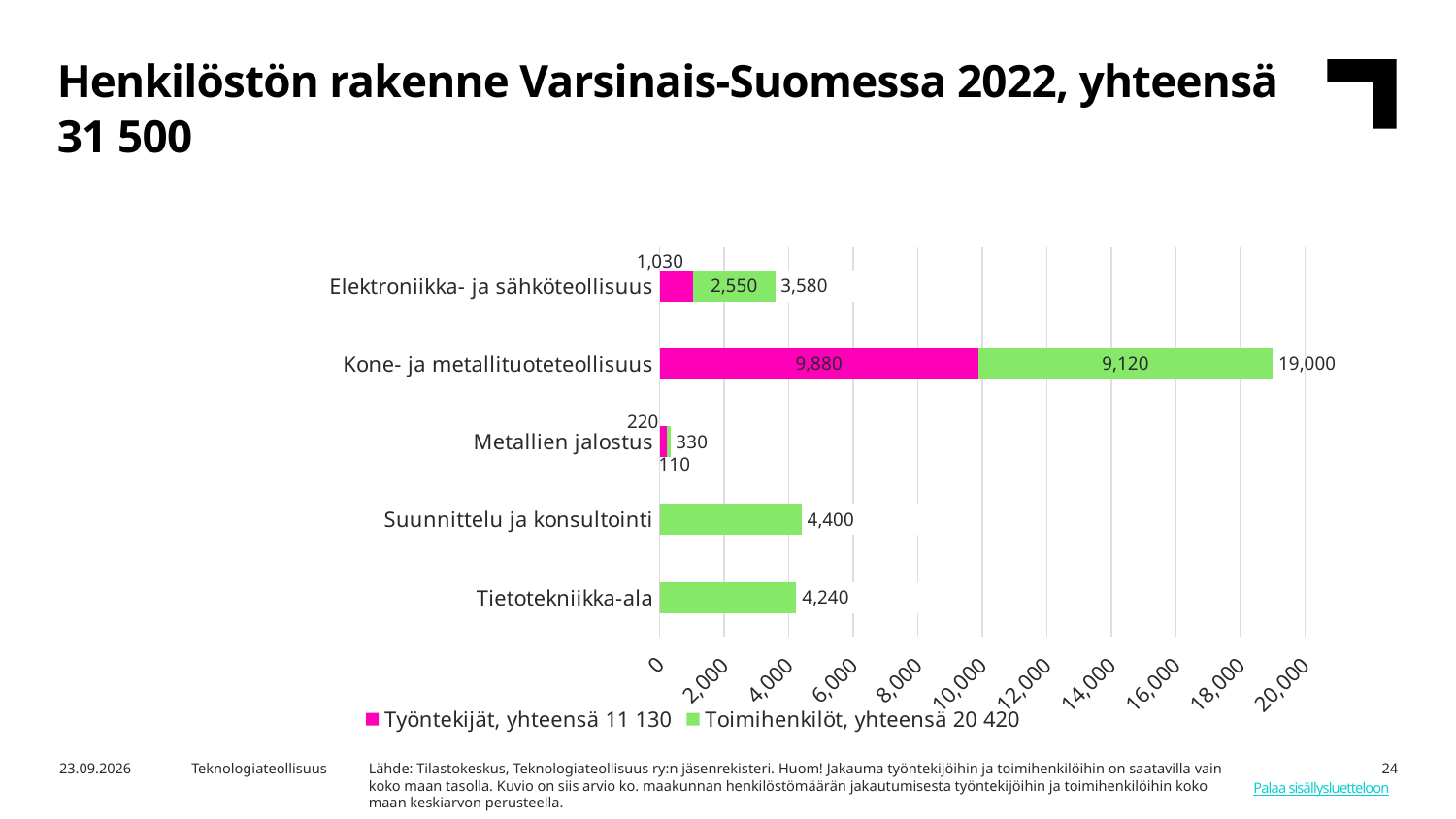
Which is larger, the Työntekijät value or the Toimihenkilöt value for Kone- ja metallituoteteollisuus? Työntekijät What is the difference between the totals for Suunnittelu ja konsultointi and Tietotekniikka-ala? 160 Which category has the highest total? Kone- ja metallituoteteollisuus How many series does the legend list? 2 What is the Toimihenkilöt value for Elektroniikka- ja sähköteollisuus? 2,550 What is the total for the Metallien jalostus bar? 330 What total is given for Toimihenkilöt in the legend? 20 420 Which category has the lowest total? Metallien jalostus How many categories are shown on the chart? 5 What kind of chart is shown on the slide? Stacked bar chart What is the total for the Kone- ja metallituoteteollisuus bar? 19,000 What is the Työntekijät value for Kone- ja metallituoteteollisuus? 9,880